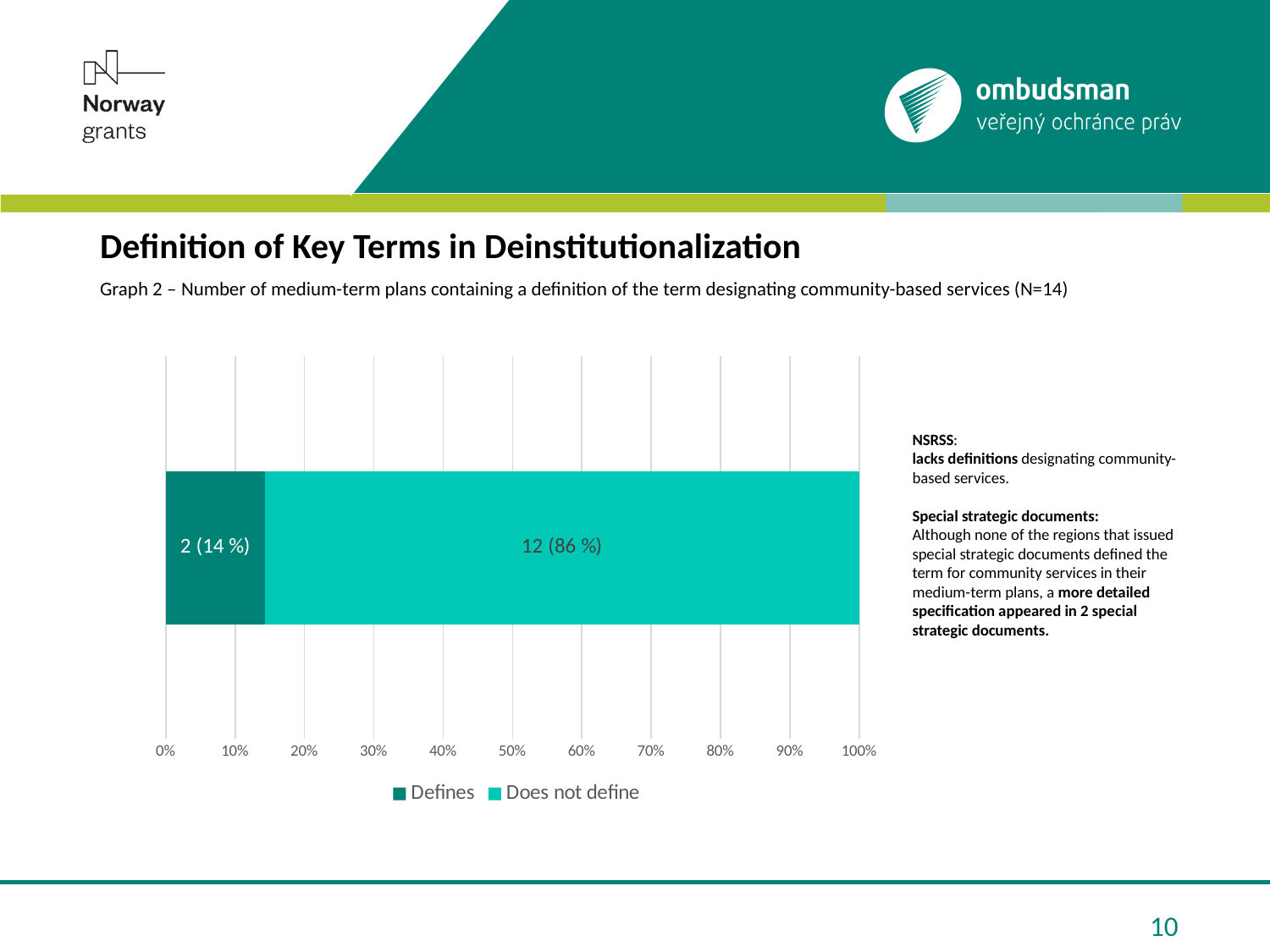
What is the total number of plans represented by the stacked bar? 14 Is the share for "Does not define" greater or less than 50%? greater Which series has the smallest value in the chart? Defines How many series does the legend list? 2 How many more plans are in the "Does not define" segment than in the "Defines" segment? 10 What is the maximum value shown on the horizontal axis? 100% Is the share for "Defines" greater or less than 20%? less What value is shown for the "Defines" segment of the bar? 2 (14 %) What are the two legend entries of the chart? Defines; Does not define What kind of chart is shown on the slide? Bar chart What value is shown for the "Does not define" segment of the bar? 12 (86 %) Which series has the larger value, "Defines" or "Does not define"? Does not define